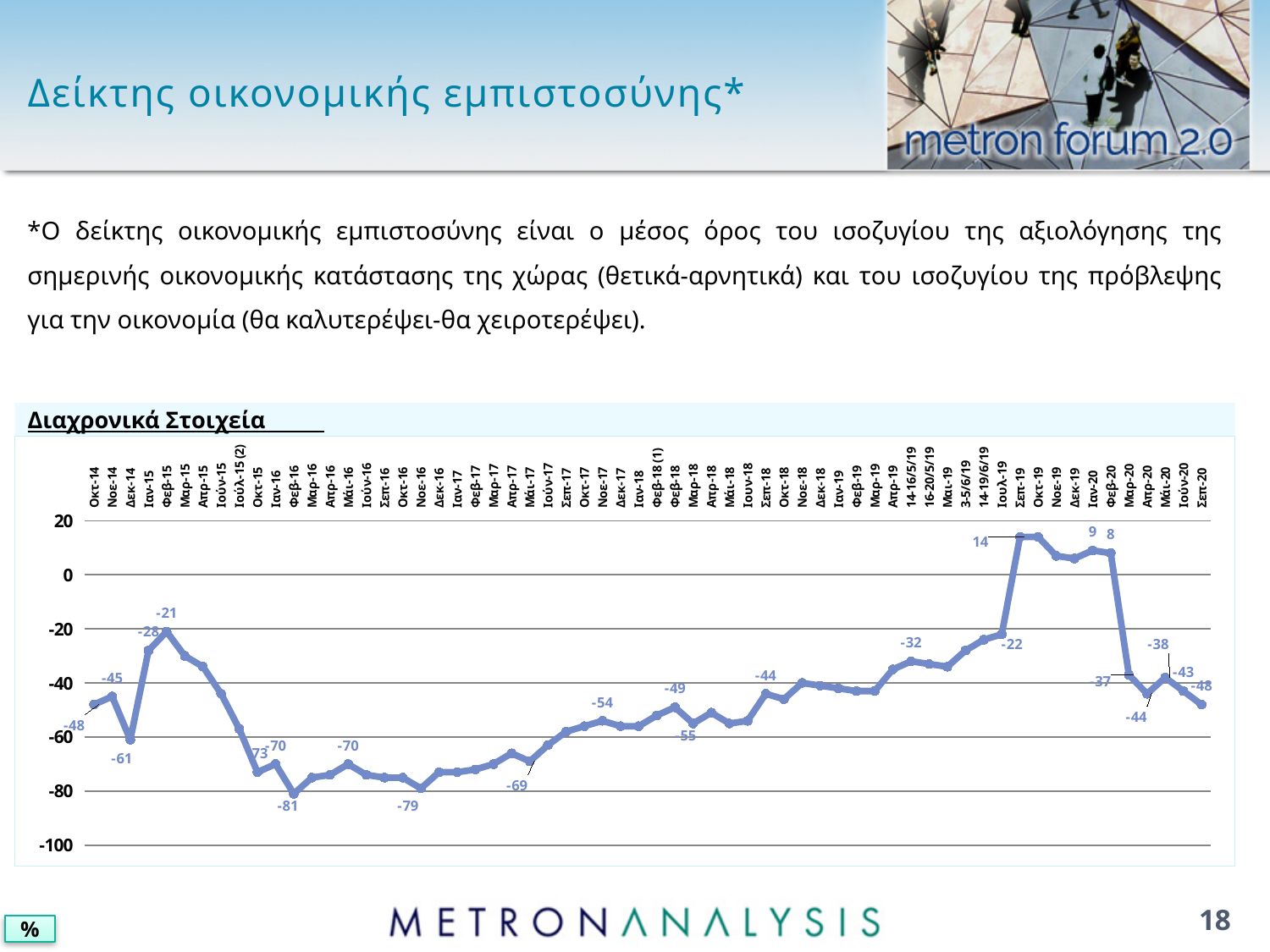
What is the heading shown above the chart? Διαχρονικά Στοιχεία What is the value for Φεβ-15? -21 Which period has the highest value on the chart? Σεπ-19 and Οκτ-19 (both 14) What is the value for Σεπ-20? -48 Which period has the lowest value on the chart? Φεβ-16 Is the value for Μαρ-15 greater or less than -20? less What is the difference between the value for Σεπ-19 and the value for Φεβ-16? 95 What kind of chart is shown on the slide? line chart Do the values rise or fall between Φεβ-16 and Ιουλ-19? rise What is the value for Ιούν-20? -43 Which is larger, the value for Σεπ-19 or the value for Φεβ-20? Σεπ-19 What is the value for Φεβ-16? -81